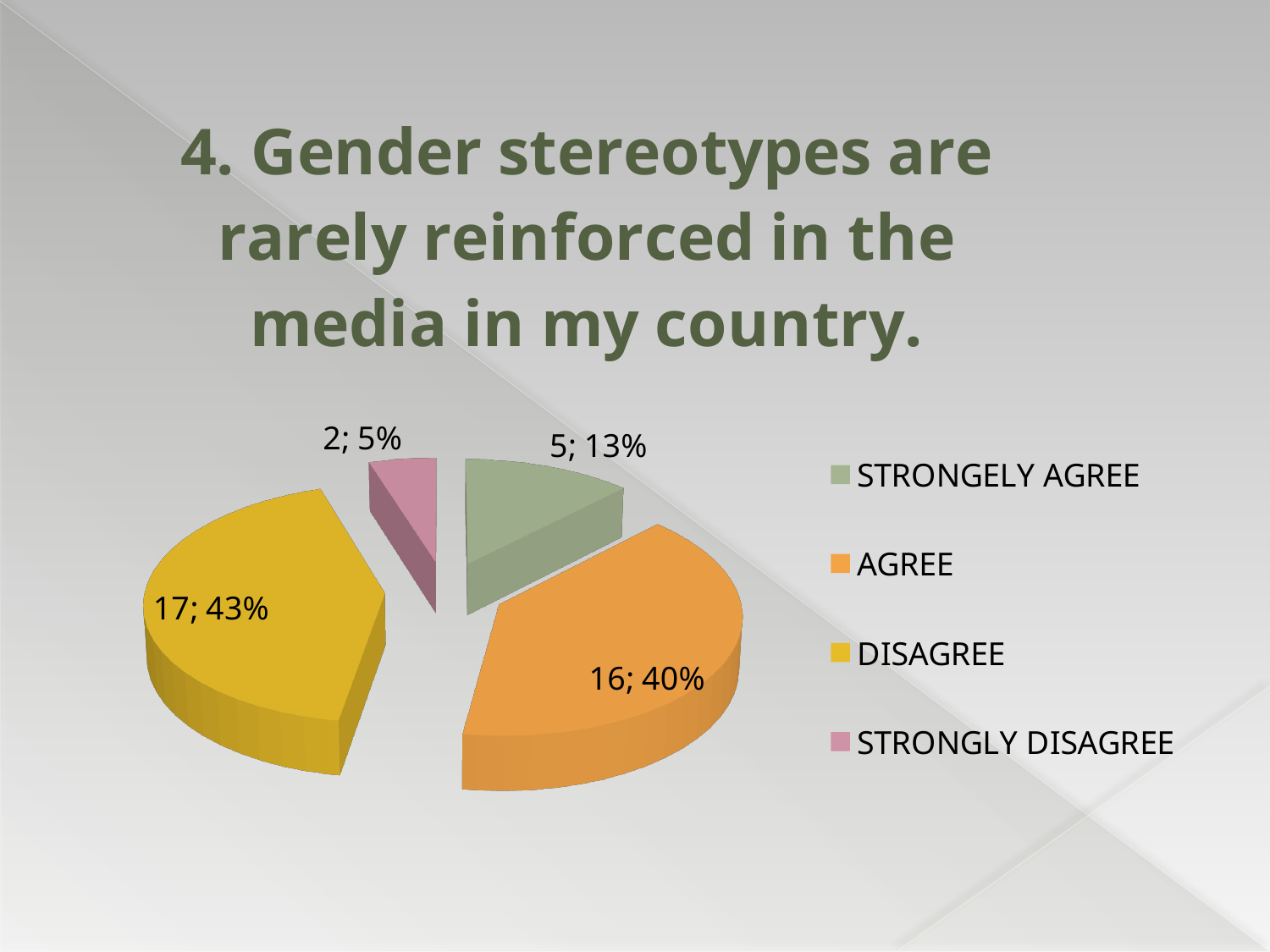
How many respondents chose STRONGLY DISAGREE? 2 Which category has the largest slice? DISAGREE Which category has the smallest slice? STRONGLY DISAGREE What is the total count across all slices? 40 What percentage of the pie is the AGREE slice? 40% How many categories does the legend list? 4 Which is larger, the count for STRONGLY AGREE or the count for STRONGLY DISAGREE? STRONGLY AGREE What is the difference in count between DISAGREE and AGREE? 1 What kind of chart is shown on the slide? pie chart How many respondents chose DISAGREE? 17 What colour is the DISAGREE slice? yellow What percentage of the pie is the STRONGLY AGREE slice? 13%